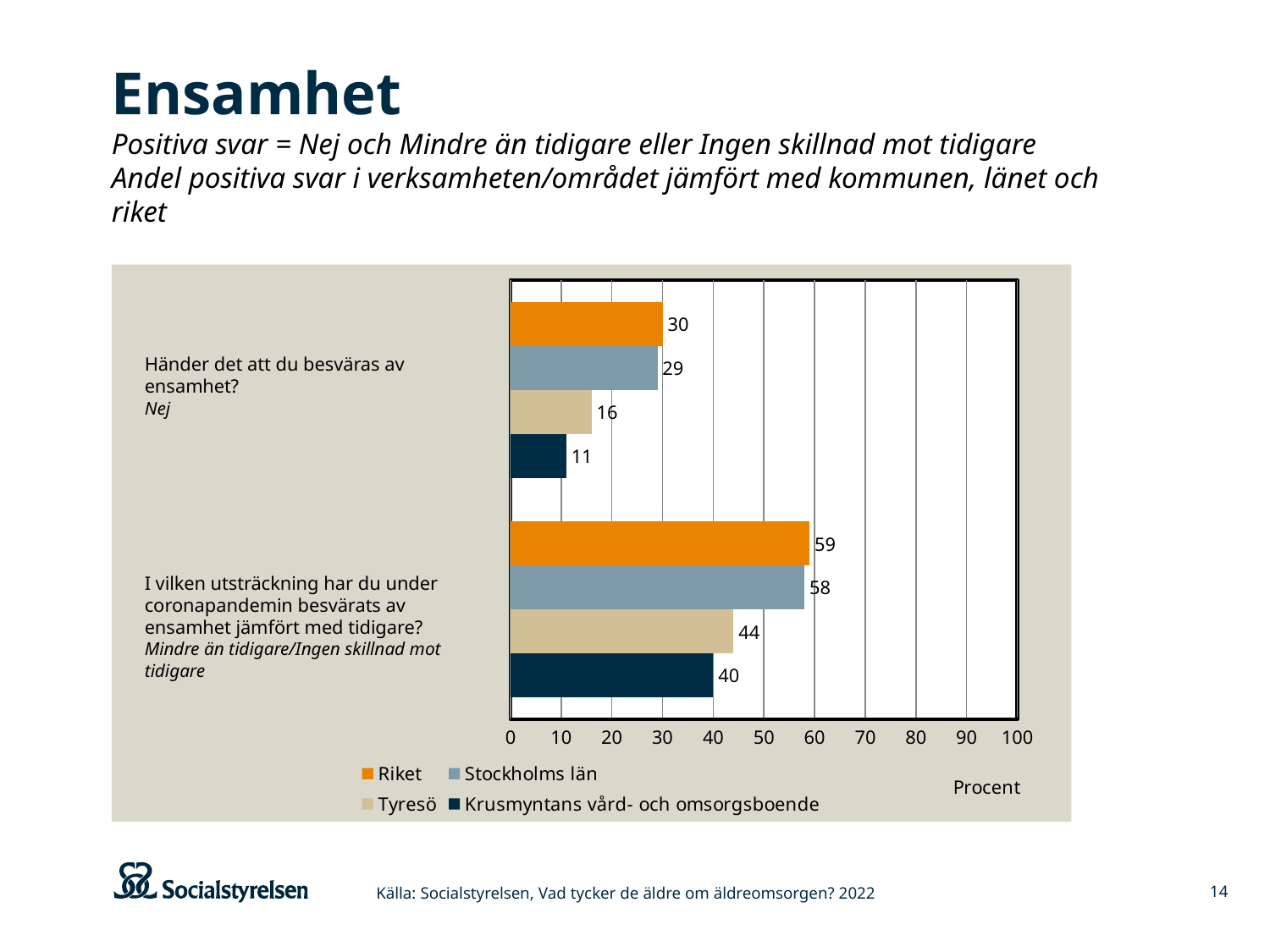
What unit is shown on the x axis of the chart? Procent Which series has the lowest value for the question "Händer det att du besväras av ensamhet?"? Krusmyntans vård- och omsorgsboende What is the value for Stockholms län for the question "I vilken utsträckning har du under coronapandemin besvärats av ensamhet jämfört med tidigare?"? 58 What kind of chart is shown on the slide? Bar chart How many series does the legend list? 4 What is the difference between Riket and Krusmyntans vård- och omsorgsboende for the question "Händer det att du besväras av ensamhet?"? 19 What is the difference between Tyresö and Krusmyntans vård- och omsorgsboende for the question "I vilken utsträckning har du under coronapandemin besvärats av ensamhet jämfört med tidigare?"? 4 What is the value for Riket for the question "Händer det att du besväras av ensamhet?"? 30 What is the value for Krusmyntans vård- och omsorgsboende for the question "I vilken utsträckning har du under coronapandemin besvärats av ensamhet jämfört med tidigare?"? 40 What is the value for Tyresö for the question "Händer det att du besväras av ensamhet?"? 16 Is the value for Tyresö higher for "Händer det att du besväras av ensamhet?" or for "I vilken utsträckning har du under coronapandemin besvärats av ensamhet jämfört med tidigare?"? I vilken utsträckning har du under coronapandemin besvärats av ensamhet jämfört med tidigare? Which series has the highest value for the question "I vilken utsträckning har du under coronapandemin besvärats av ensamhet jämfört med tidigare?"? Riket